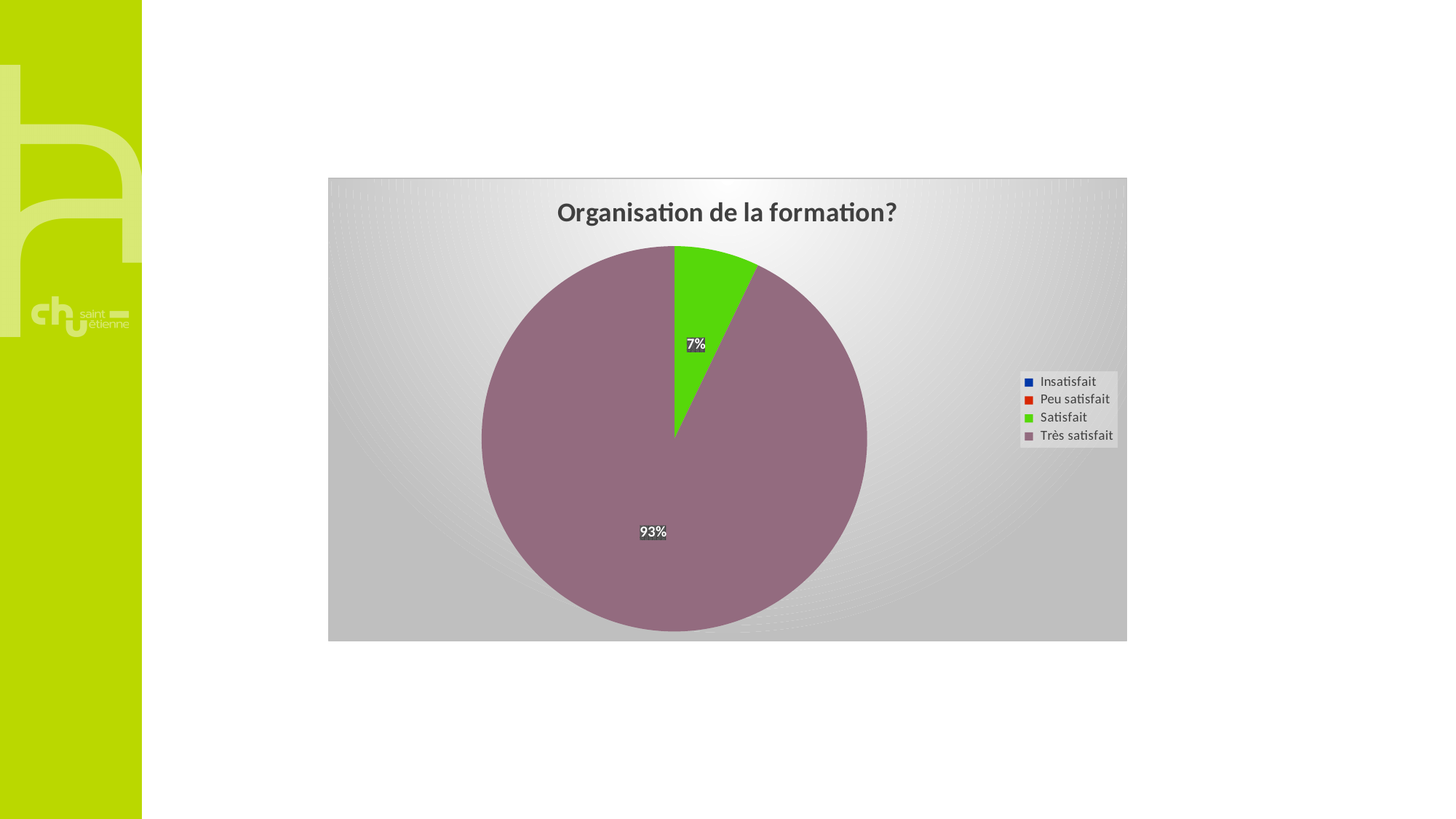
Which is larger, the 'Satisfait' slice or the 'Très satisfait' slice? Très satisfait What colour is the 'Très satisfait' slice? purple Is the share for 'Très satisfait' greater or less than 50%? greater What kind of chart is shown on the slide? pie chart What share of the pie is labelled for 'Très satisfait'? 93% What is the difference between the 'Très satisfait' and 'Satisfait' shares? 86% What share of the pie is labelled for 'Satisfait'? 7% How many entries does the legend list? 4 Which category has the largest slice of the pie? Très satisfait How many slices are visible in the pie? 2 What is the chart's title? Organisation de la formation?